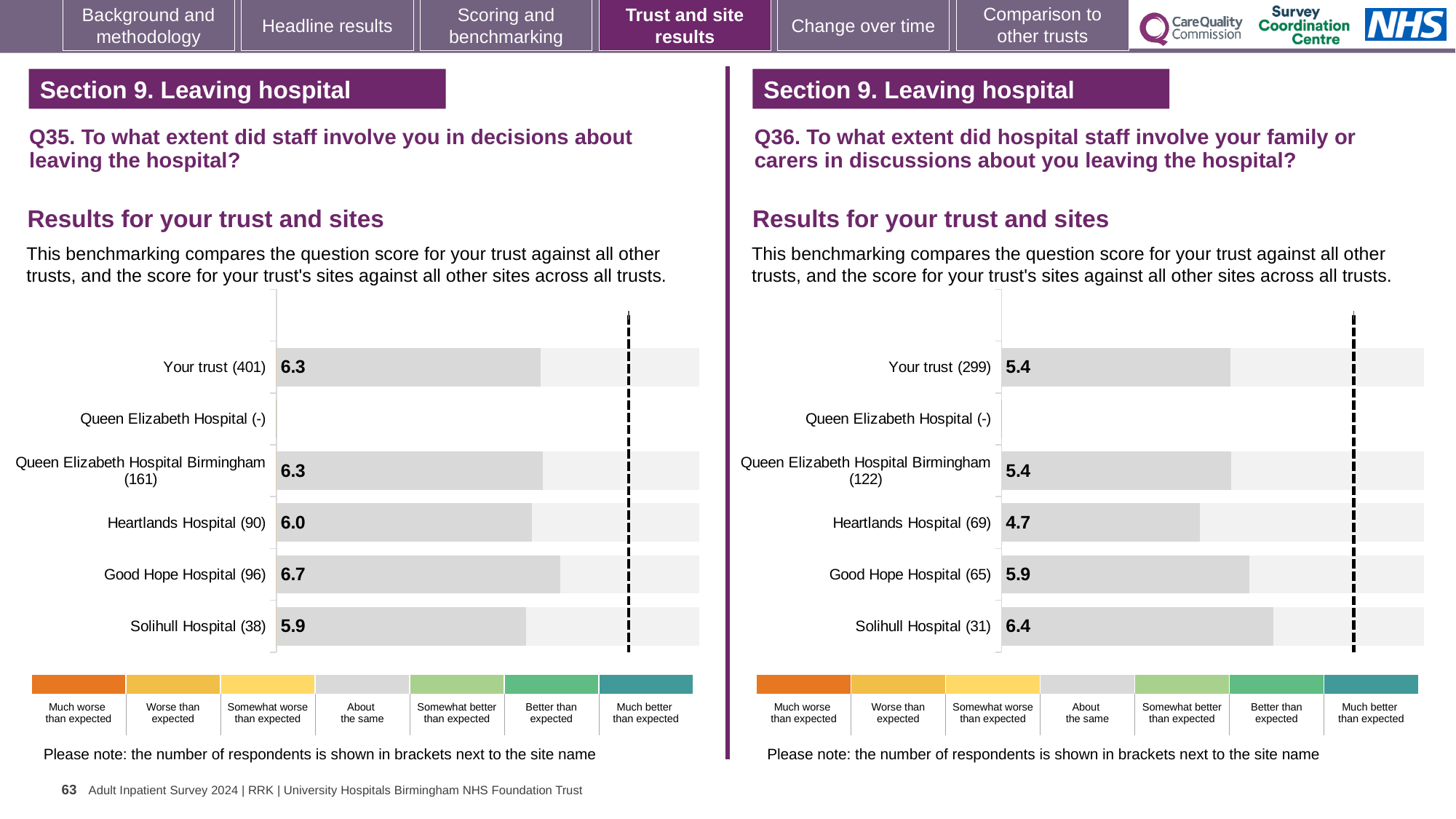
In the Q36 chart on the right, which is larger: the score for Good Hope Hospital or the score for Solihull Hospital? Solihull Hospital In the Q36 chart on the right, what is the score for Solihull Hospital? 6.4 In the Q35 chart on the left, which site has the lowest score? Solihull Hospital In the Q36 chart on the right, how many bars have a printed score? 5 In the Q35 chart on the left, what is the score for Good Hope Hospital? 6.7 In the Q36 chart on the right, which site has the lowest score? Heartlands Hospital In the Q35 chart on the left, what is the difference between the scores for Good Hope Hospital and Heartlands Hospital? 0.7 In the Q36 chart on the right, what is the difference between the scores for Solihull Hospital and Your trust? 1.0 In the Q36 chart on the right, what is the score for Heartlands Hospital? 4.7 In the Q35 chart on the left, what is the score for Your trust? 6.3 What type of chart is used on the left for Q35? Bar chart In the Q35 chart on the left, which site has the highest score? Good Hope Hospital